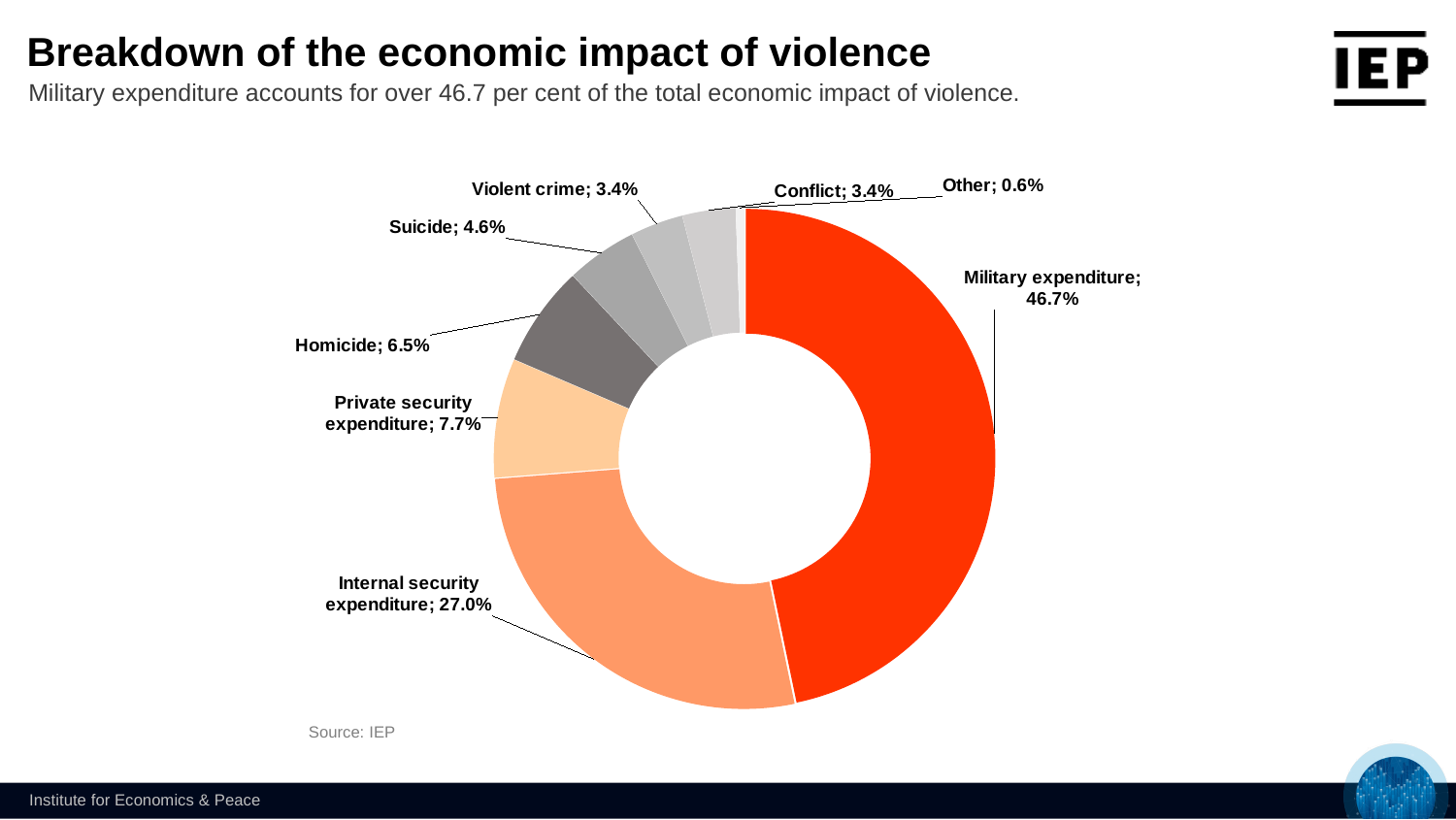
What is the combined share of violent crime and conflict? 6.8% What share of the economic impact of violence is attributed to internal security expenditure? 27.0% What share of the economic impact of violence is attributed to homicide? 6.5% What is the title of the slide's chart? Breakdown of the economic impact of violence How many categories are shown in the chart? 8 Which category has the largest share of the economic impact of violence? Military expenditure What is the difference in percentage points between the shares for military expenditure and internal security expenditure? 19.7 Which category has the smallest share of the economic impact of violence? Other Which has a larger share: private security expenditure or homicide? Private security expenditure What share of the economic impact of violence is attributed to suicide? 4.6% What kind of chart is shown on the slide? Pie chart (doughnut) What share of the economic impact of violence is attributed to military expenditure? 46.7%